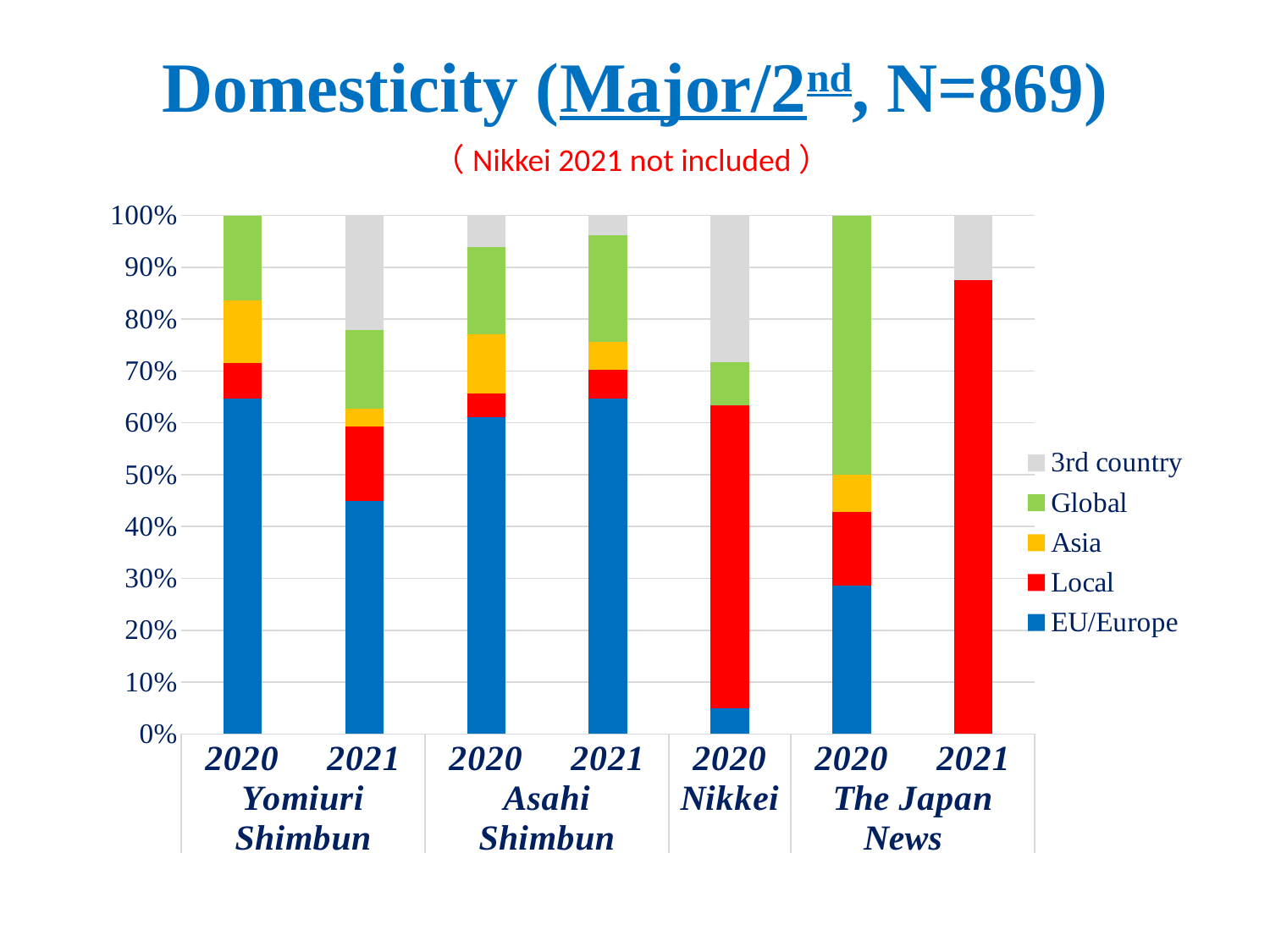
Is the Local share for The Japan News 2021 greater or less than 80%? greater Is the EU/Europe share for Yomiuri Shimbun 2021 greater or less than 50%? less According to the note under the title, which newspaper's 2021 data is not included? Nikkei Is the EU/Europe share for Yomiuri Shimbun 2020 greater or less than 60%? greater How many series does the legend list? 5 What kind of chart is shown on the slide? Stacked bar chart Which bar has the largest Local segment? The Japan News 2021 Which has the larger EU/Europe share, Yomiuri Shimbun 2020 or Nikkei 2020? Yomiuri Shimbun 2020 Which bar has the largest Global segment? The Japan News 2020 How many bars are plotted in the chart? 7 Which series is shown in red in the legend? Local